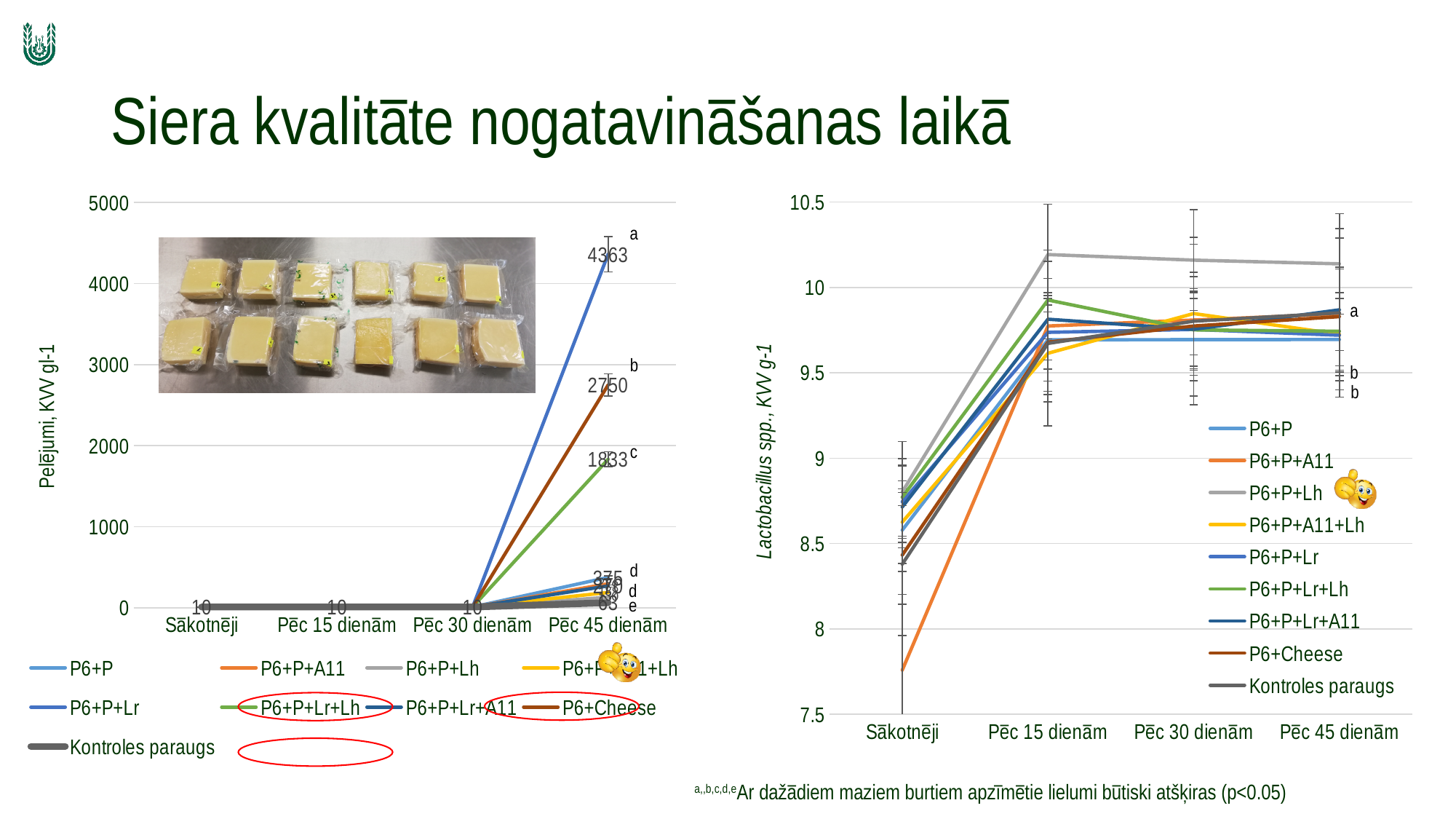
In the left chart (Pelējumi, KW gl-1), what is the highest value shown at Pēc 45 dienām? 4363 What kind of chart is the left chart (Pelējumi, KW gl-1)? line chart In the right chart (Lactobacillus spp., KW g-1), which series has the highest value at Pēc 45 dienām? P6+P+Lh In the left chart (Pelējumi, KW gl-1), what is the difference between the values for P6+P+Lr and P6+Cheese at Pēc 45 dienām? 1613 How many series does the legend of the right chart (Lactobacillus spp., KW g-1) list? 9 In the left chart (Pelējumi, KW gl-1), what value is labelled at Sākotnēji? 10 How many categories are on the x axis of the left chart (Pelējumi, KW gl-1)? 4 In the right chart (Lactobacillus spp., KW g-1), does the P6+P+Lh line rise or fall from Sākotnēji to Pēc 15 dienām? rise In the left chart (Pelējumi, KW gl-1), which is larger at Pēc 45 dienām: P6+P+Lr or P6+Cheese? P6+P+Lr In the left chart (Pelējumi, KW gl-1), what is the value for P6+P+Lr+Lh at Pēc 45 dienām? 1833 In the right chart (Lactobacillus spp., KW g-1), is the value for P6+P+A11 at Sākotnēji greater or less than 8? less In the left chart (Pelējumi, KW gl-1), what is the value for P6+Cheese at Pēc 45 dienām? 2750